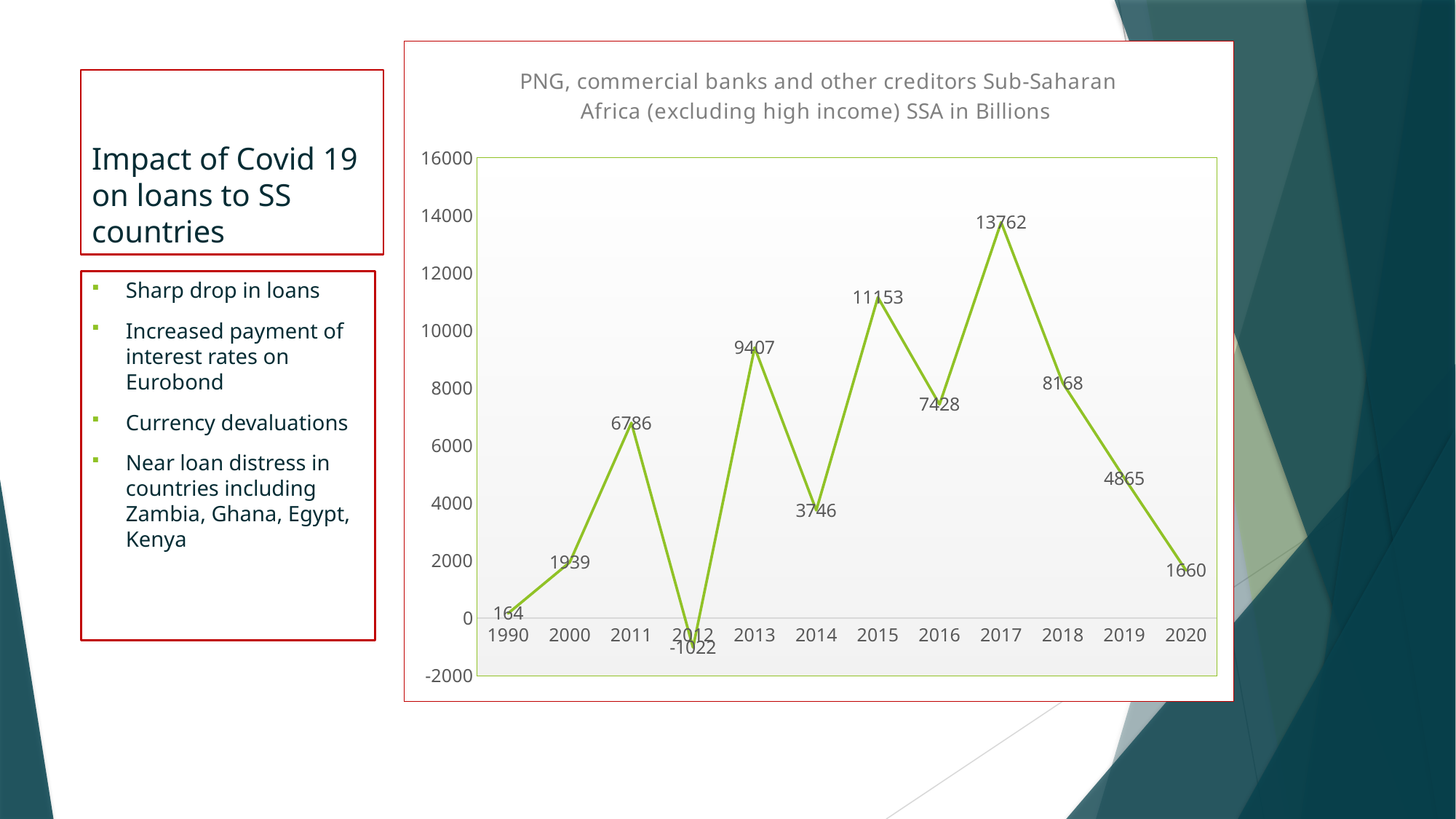
What is the title of the chart? PNG, commercial banks and other creditors Sub-Saharan Africa (excluding high income) SSA in Billions What kind of chart is shown? Line chart What is the value for 2012? -1022 Which year has the lowest value? 2012 Do the values rise or fall from 2017 to 2020? Fall What is the value for 2020? 1660 What is the value for 2017? 13762 Which year has the highest value? 2017 How many years are plotted on the x axis? 12 What is the difference between the values for 2017 and 2018? 5594 What is the value for 1990? 164 Which is larger, the value for 2015 or the value for 2016? 2015